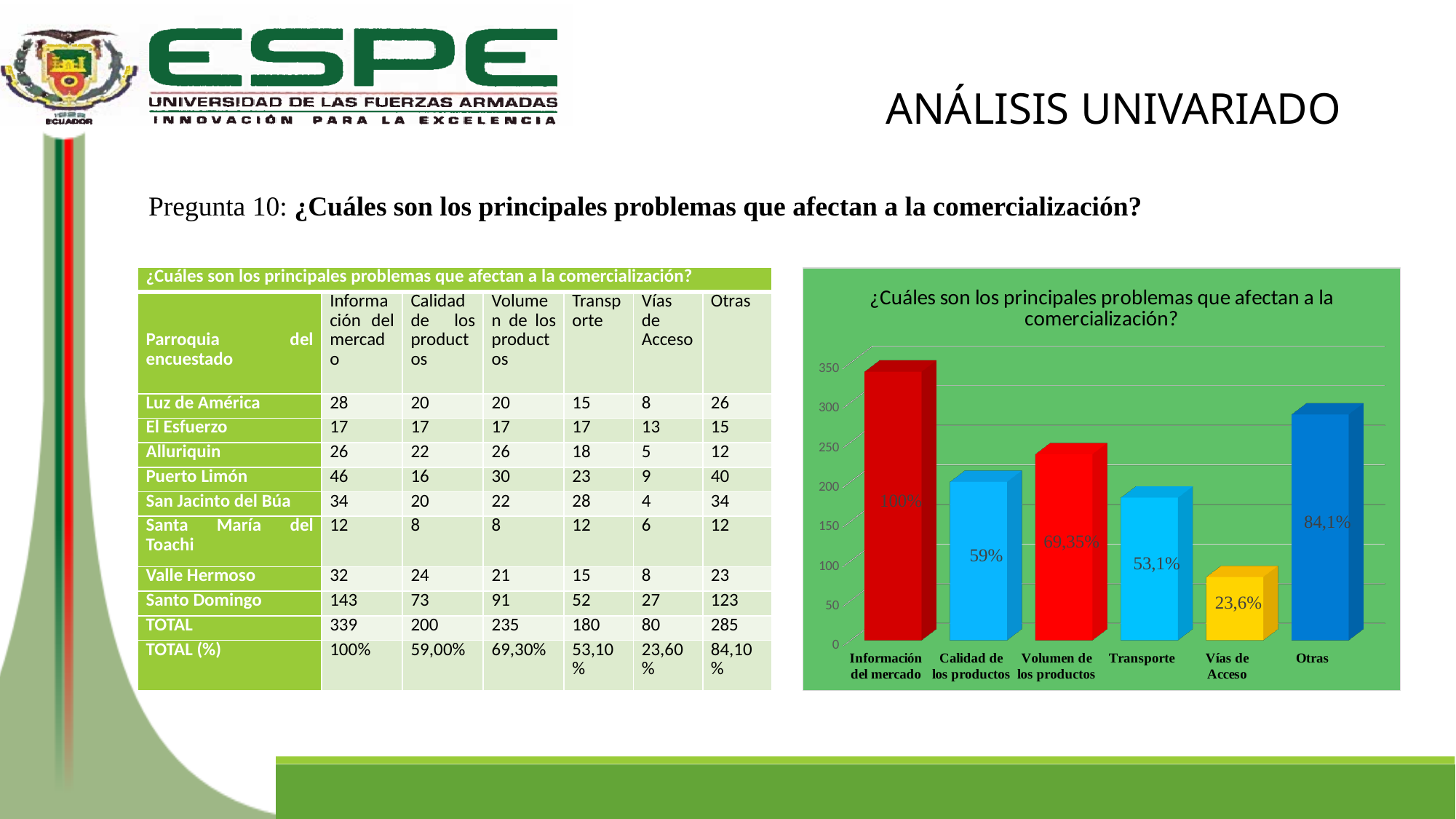
What kind of chart is shown on the slide? bar chart What is the data label shown on the bar for Información del mercado? 100% What is the data label shown on the bar for Transporte? 53,1% What is the data label shown on the bar for Vías de Acceso? 23,6% Is the bar for Otras greater or less than 250 on the vertical axis? greater What is the data label shown on the bar for Volumen de los productos? 69,35% What is the data label shown on the bar for Calidad de los productos? 59% How many categories are plotted in the bar chart? 6 Which category has the tallest bar in the chart? Información del mercado What is the data label shown on the bar for Otras? 84,1% Which category has the shortest bar in the chart? Vías de Acceso Is the bar for Vías de Acceso greater or less than 100 on the vertical axis? less